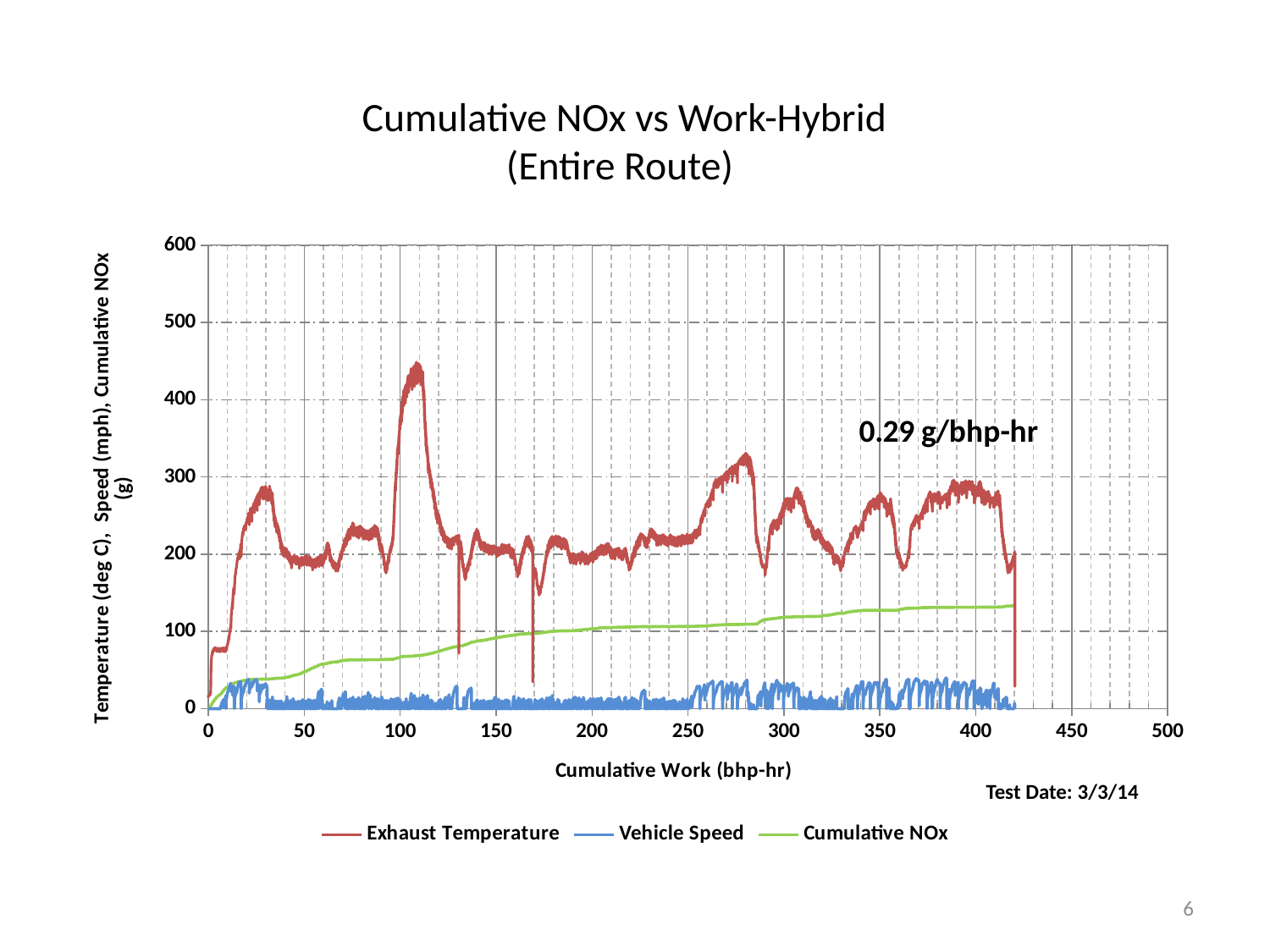
What kind of chart is shown on the slide? line chart Is the Vehicle Speed series ever greater or less than 100 on the y axis? less Is the peak value of Exhaust Temperature near 100 bhp-hr greater or less than 400? greater What NOx rate is annotated on the chart? 0.29 g/bhp-hr What is the label of the x axis? Cumulative Work (bhp-hr) Is the Cumulative NOx value at the end of the route (around 420 bhp-hr) greater or less than 100? greater How many series does the legend list? 3 Which is larger at 300 bhp-hr, Exhaust Temperature or Cumulative NOx? Exhaust Temperature Does the Cumulative NOx series rise or fall along the x axis? rise What is the title of the chart? Cumulative NOx vs Work-Hybrid (Entire Route) Which series reaches the highest value on the chart? Exhaust Temperature Which series stays lowest on the chart over most of the route? Vehicle Speed